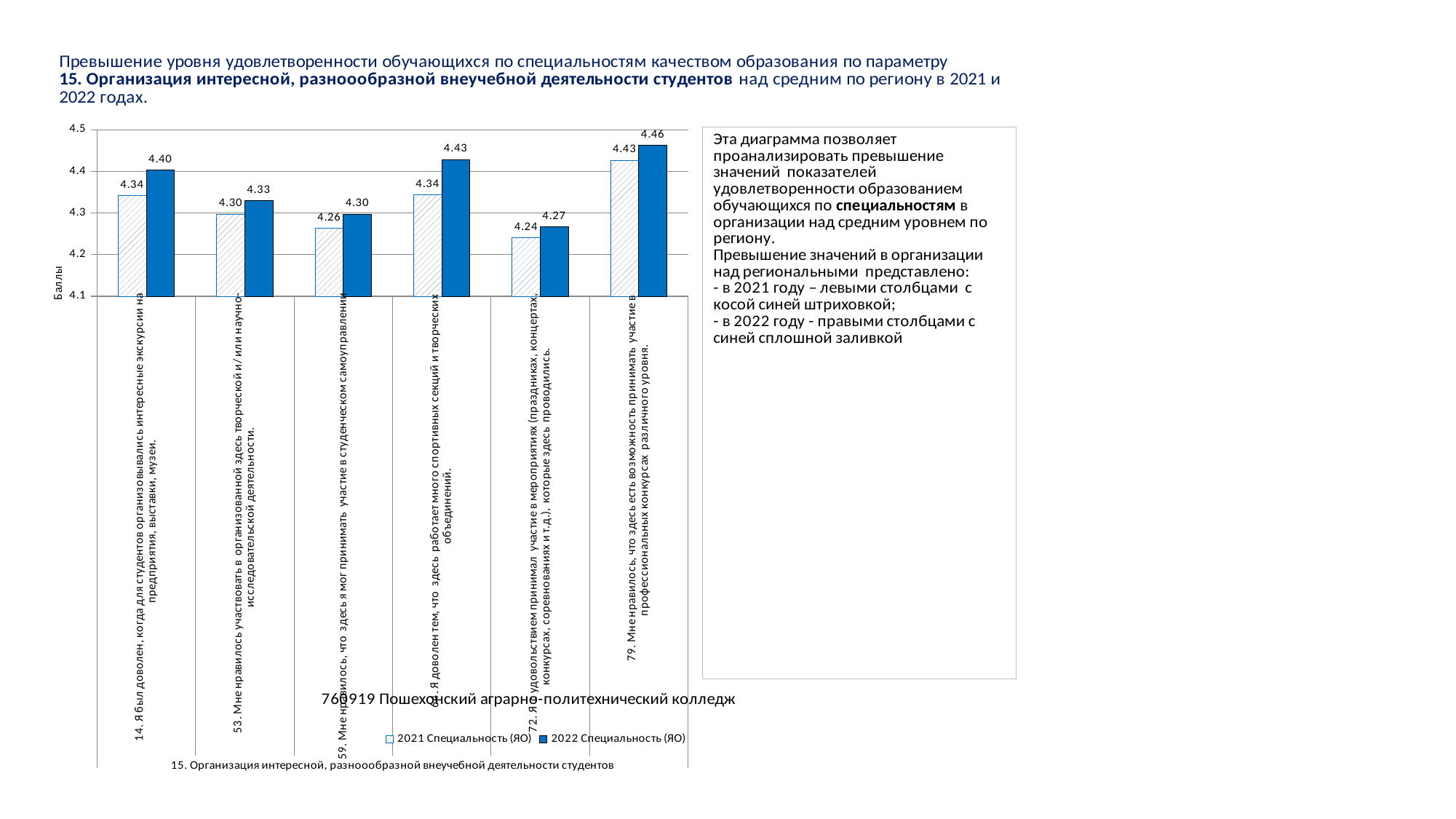
Is the 2022 Специальность (ЯО) value for statement 79 greater or less than 4.4? greater Which statement has the highest 2022 Специальность (ЯО) value? 79. Мне нравилось, что здесь есть возможность принимать участие в профессиональных конкурсах различного уровня. Which is larger for statement 53: the 2021 Специальность (ЯО) value or the 2022 Специальность (ЯО) value? 2022 Специальность (ЯО) What type of chart is shown on the slide? bar chart What is the label of the vertical axis of the chart? Баллы What is the 2021 Специальность (ЯО) value for statement 72 (Я с удовольствием принимал участие в мероприятиях)? 4.24 What is the 2022 Специальность (ЯО) value for statement 14 (Я был доволен, когда для студентов организовывались интересные экскурсии на предприятия, выставки, музеи)? 4.40 What is the 2021 Специальность (ЯО) value for statement 59 (Мне нравилось, что здесь я мог принимать участие в студенческом самоуправлении)? 4.26 How many series does the chart legend list? 2 Which statement has the lowest 2021 Специальность (ЯО) value? 72. Я с удовольствием принимал участие в мероприятиях (праздниках, концертах, конкурсах, соревнованиях и т.д.), которые здесь проводились. What is the difference between the 2022 and 2021 Специальность (ЯО) values for the statement about sports sections and creative associations (спортивных секций и творческих объединений)? 0.09 How many statements (categories) are shown on the x axis of the chart? 6